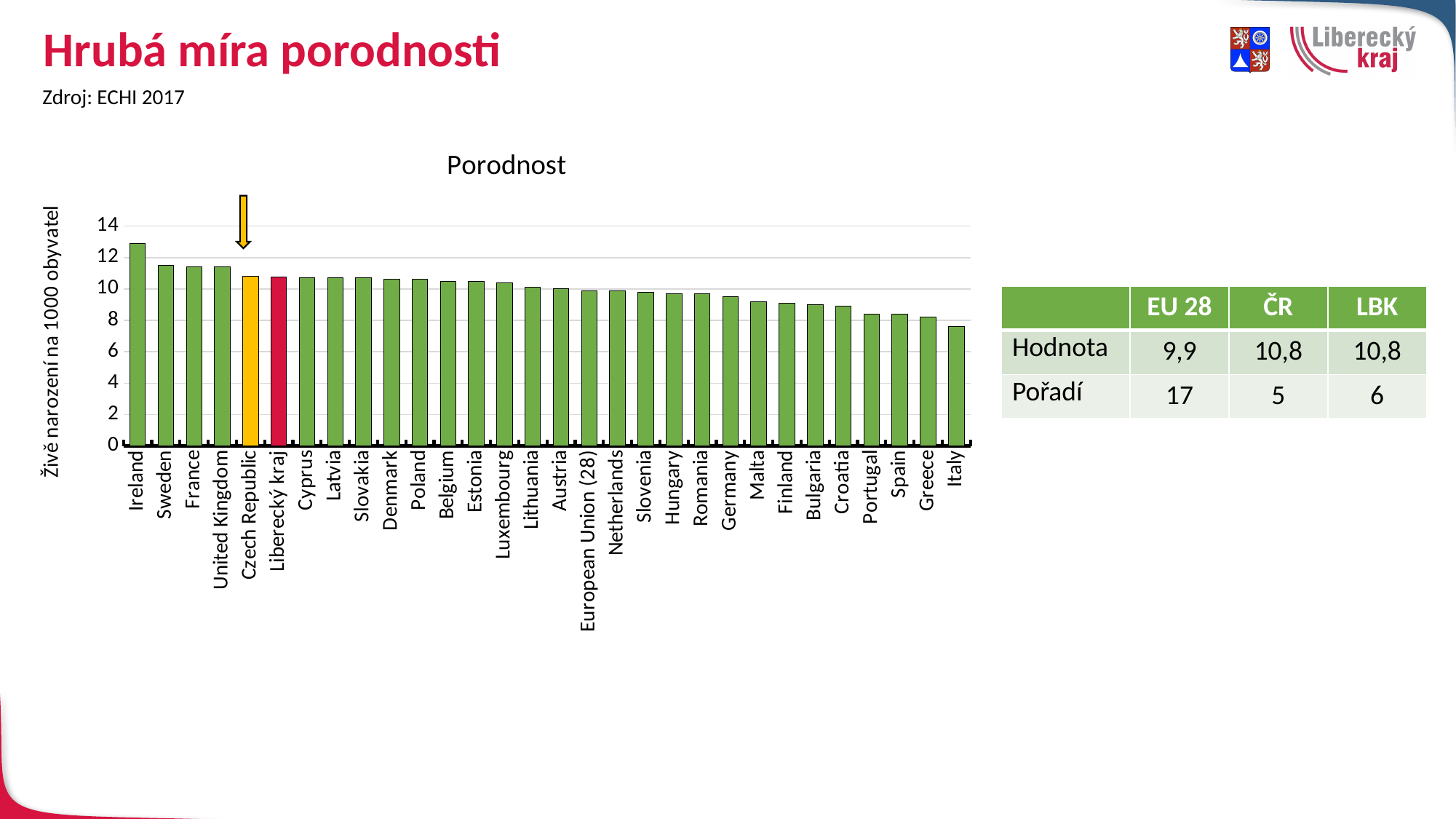
What kind of chart is shown on the slide? bar chart Which has a larger value, Sweden or Greece? Sweden Is the value for Germany greater or less than 10? less According to the table on the slide, what is the value (Hodnota) for EU 28? 9,9 Which bar in the chart is coloured red? Liberecký kraj Do the values rise or fall from left to right along the x axis? fall Is the value for Ireland greater or less than 12? greater Which country has the lowest value in the chart? Italy What is the title of the chart? Porodnost Which country has the highest value in the chart? Ireland How many categories (bars) are plotted in the chart? 30 Is the value for Italy greater or less than 8? less